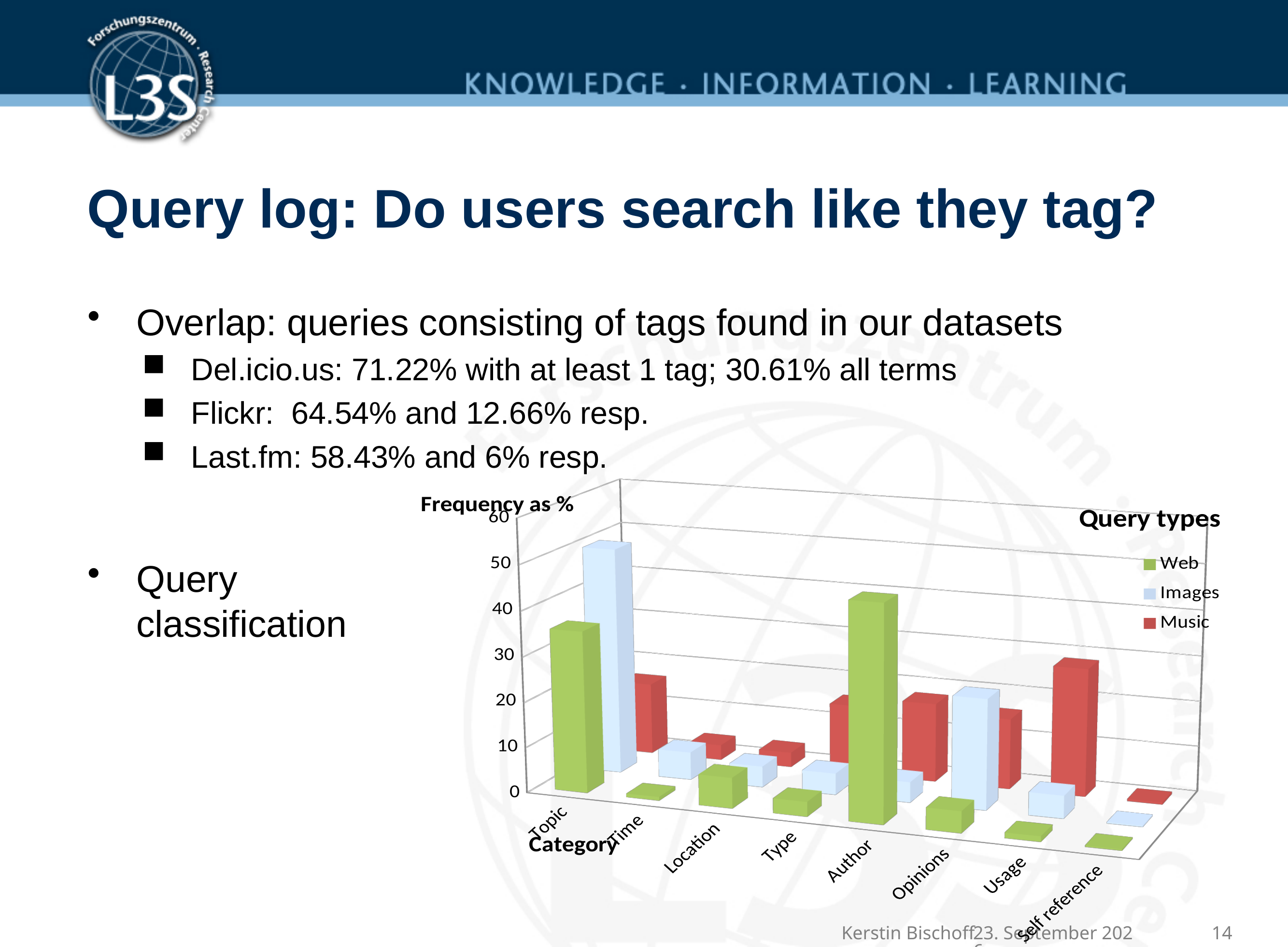
Is the Web value for Author greater or less than 30? greater How many categories are shown on the category axis of the chart? 8 For the Topic category, which is larger: the Web value or the Images value? Images What kind of chart is shown on the slide? bar chart For which category is the Images series highest? Topic For which category is the Web series highest? Author What is the label of the vertical axis of the chart? Frequency as % For the Author category, which is larger: the Web value or the Images value? Web How many series does the chart legend list? 3 Is the Images value for Topic greater or less than 40? greater What is the title of the chart's legend? Query types Is the Web value for Time greater or less than 10? less